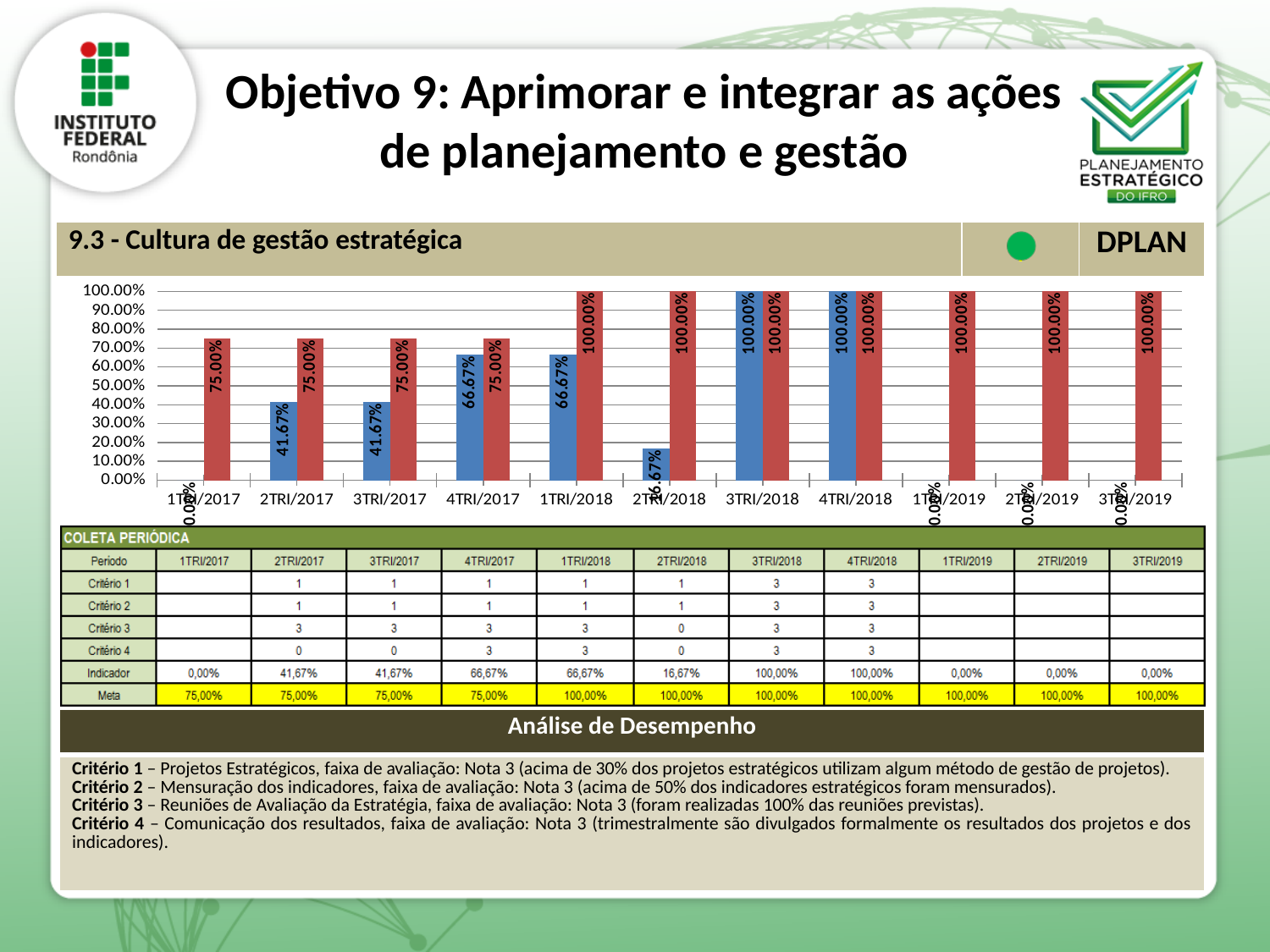
Which period has the lowest blue bar value among 2TRI/2017 to 4TRI/2018? 2TRI/2018 What is the value of the blue bar for 4TRI/2017? 66.67% Which is larger for 1TRI/2018, the blue bar or the red bar? the red bar What is the highest value reached by the blue bars in the chart? 100.00% What type of chart is shown on the slide? bar chart What is the difference between the red bar and the blue bar for 2TRI/2018? 83.33% What is the difference between the red bar and the blue bar for 4TRI/2017? 8.33% What is the value of the blue bar for 2TRI/2017? 41.67% What is the value of the blue bar for 2TRI/2018? 16.67% What is the value of the red bar for 3TRI/2017? 75.00% How many periods (categories) are shown on the x axis of the chart? 11 Is the value of the blue bar for 2TRI/2018 greater or less than 20.00%? less